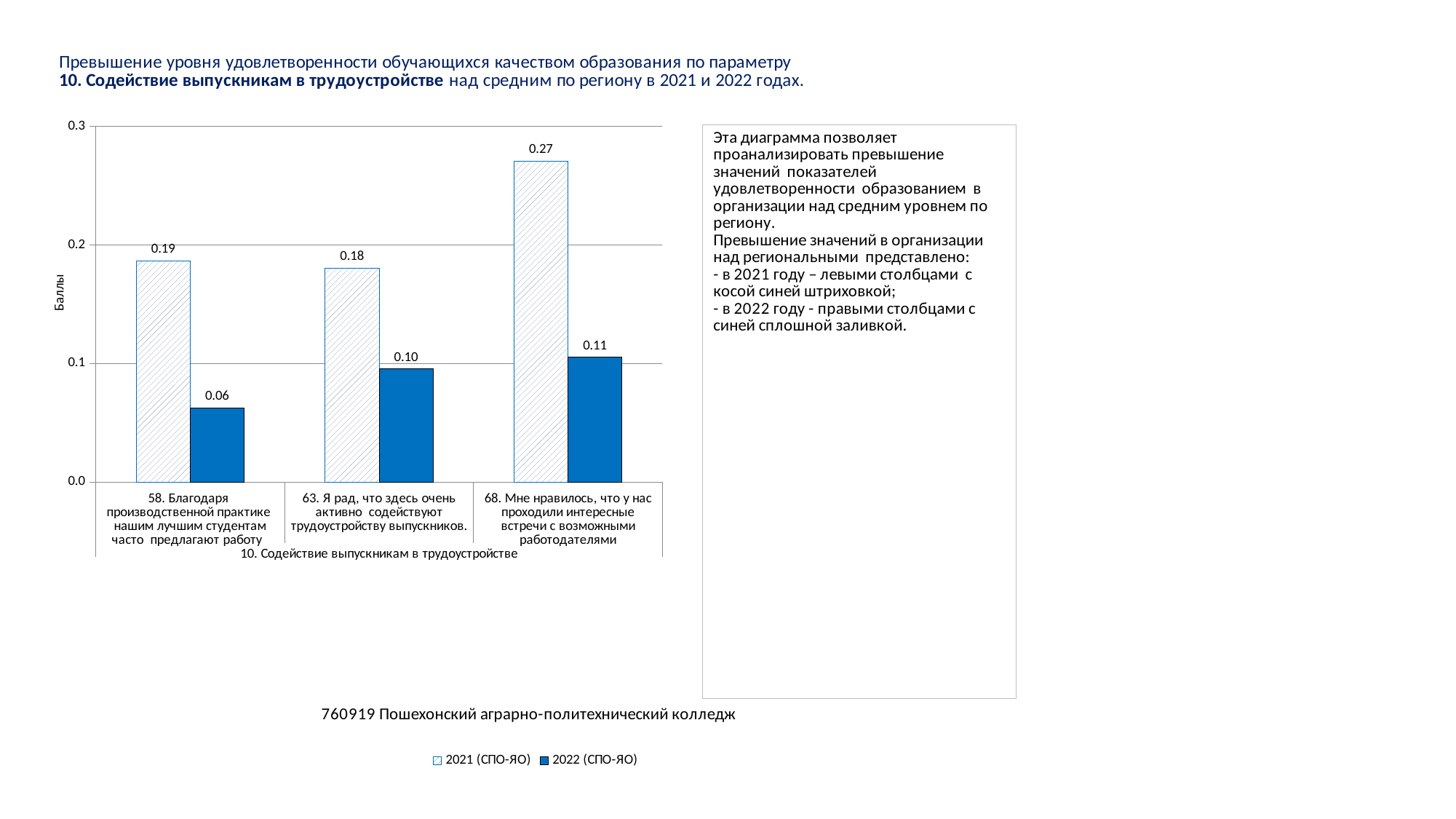
What is the difference between the 2021 and 2022 values for category 68? 0.16 What is the label of the vertical axis of the chart? Баллы What is the 2021 (СПО-ЯО) value for category 58 (Благодаря производственной практике нашим лучшим студентам часто предлагают работу)? 0.19 How many categories are shown on the x axis of the chart? 3 What is the 2022 (СПО-ЯО) value for category 68 (Мне нравилось, что у нас проходили интересные встречи с возможными работодателями)? 0.11 Which category has the lowest 2022 (СПО-ЯО) value? 58. Благодаря производственной практике нашим лучшим студентам часто предлагают работу What is the 2022 (СПО-ЯО) value for category 63 (Я рад, что здесь очень активно содействуют трудоустройству выпускников)? 0.10 Is the 2021 (СПО-ЯО) value for category 68 greater or less than 0.2? greater For category 58, which series has the larger value, 2021 (СПО-ЯО) or 2022 (СПО-ЯО)? 2021 (СПО-ЯО) Which category has the highest 2021 (СПО-ЯО) value? 68. Мне нравилось, что у нас проходили интересные встречи с возможными работодателями What type of chart is shown on the slide? bar chart How many series does the chart legend list? 2